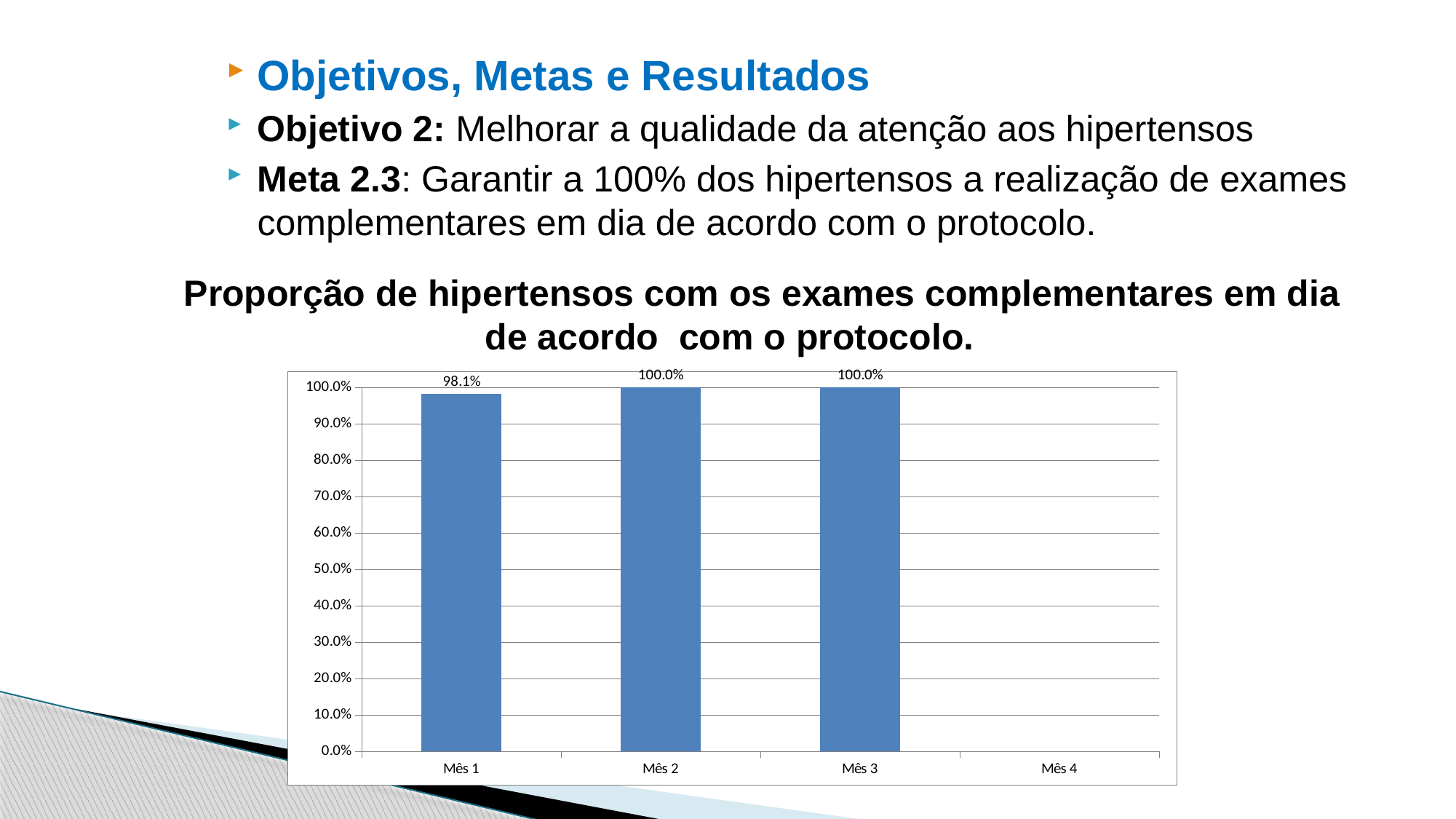
What kind of chart is shown on the slide? Bar chart What is the value for Mês 3? 100.0% Does the value rise or fall from Mês 1 to Mês 2? Rise What is the value for Mês 2? 100.0% What is the title of the chart? Proporção de hipertensos com os exames complementares em dia de acordo com o protocolo. Which is larger, the value for Mês 1 or the value for Mês 2? Mês 2 What is the value for Mês 1? 98.1% Which month has the lowest value among the plotted bars? Mês 1 What is the difference between the values for Mês 2 and Mês 1? 1.9% Is the value for Mês 1 greater or less than 90.0%? greater How many categories are shown on the x axis? 4 Which category on the x axis has no bar plotted? Mês 4